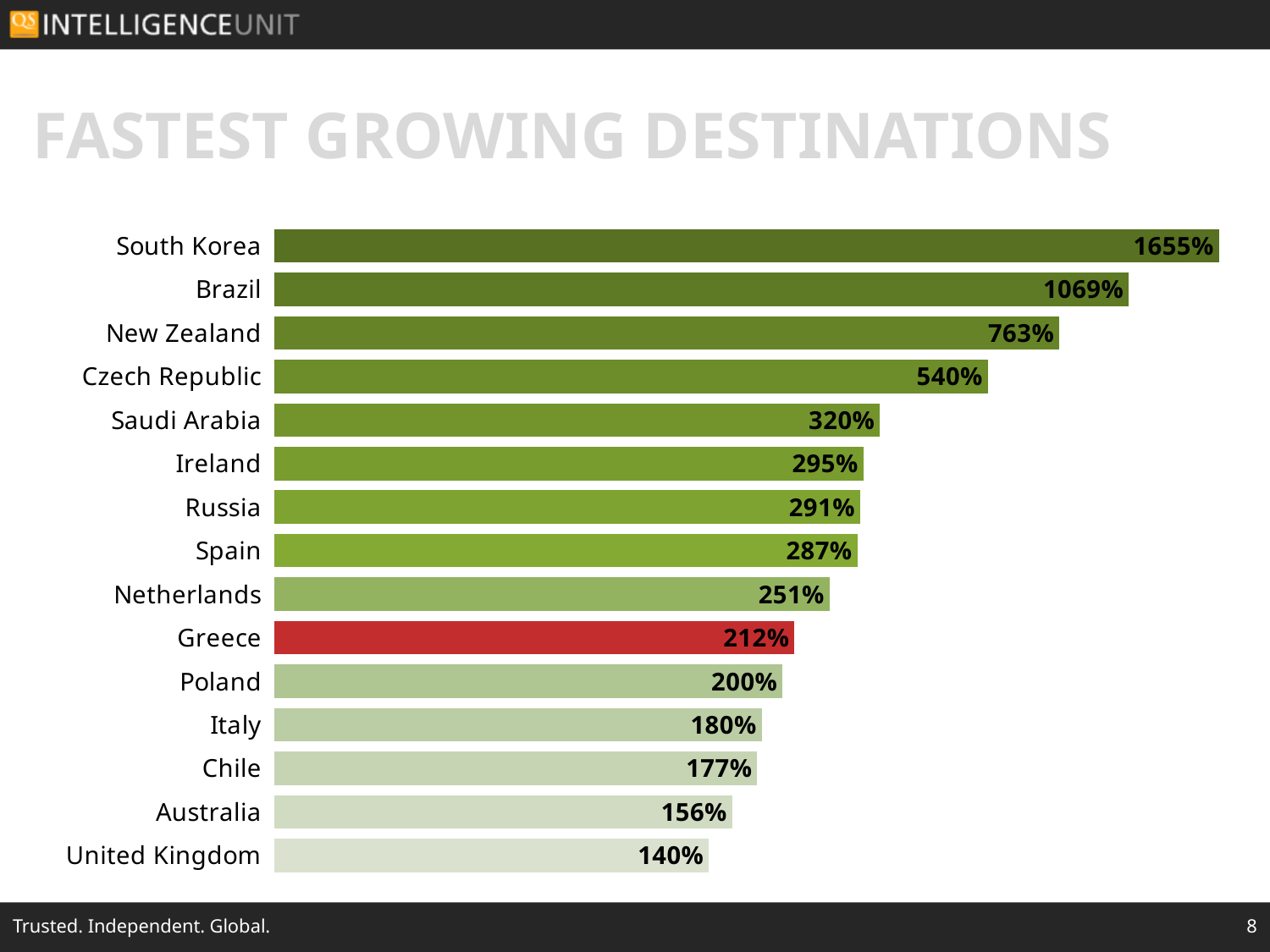
Which destination has the lowest value? United Kingdom How many destinations are shown in the chart? 15 What is the value for Greece? 212% Which destination has the highest value? South Korea What is the title of the slide? FASTEST GROWING DESTINATIONS What is the value for Czech Republic? 540% What is the difference between the values for Australia and United Kingdom? 16% Which has a larger value, Saudi Arabia or Netherlands? Saudi Arabia What is the difference between the values for Brazil and New Zealand? 306% What kind of chart is shown on the slide? Bar chart Which destination's bar is coloured red? Greece What is the value for South Korea? 1655%